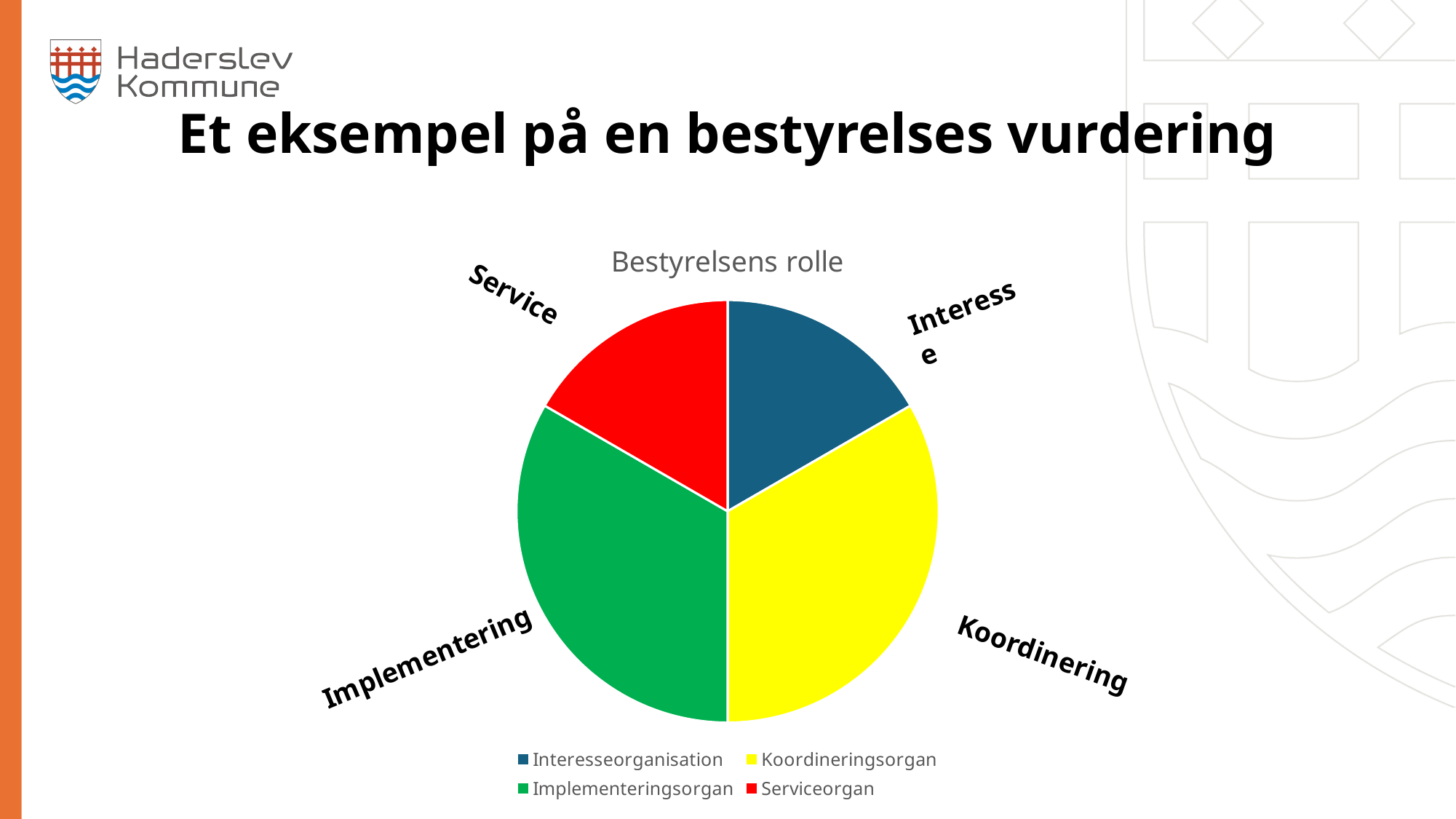
Which colour represents Koordineringsorgan in the pie chart? yellow What is the title of the pie chart? Bestyrelsens rolle Which slice is larger in the pie chart, Koordineringsorgan or Interesseorganisation? Koordineringsorgan How many slices does the pie chart have? 4 How many entries does the legend of the pie chart list? 4 Which slice is larger in the pie chart, Serviceorgan or Koordineringsorgan? Koordineringsorgan Which slice is larger in the pie chart, Implementeringsorgan or Serviceorgan? Implementeringsorgan What kind of chart is shown on the slide? pie chart